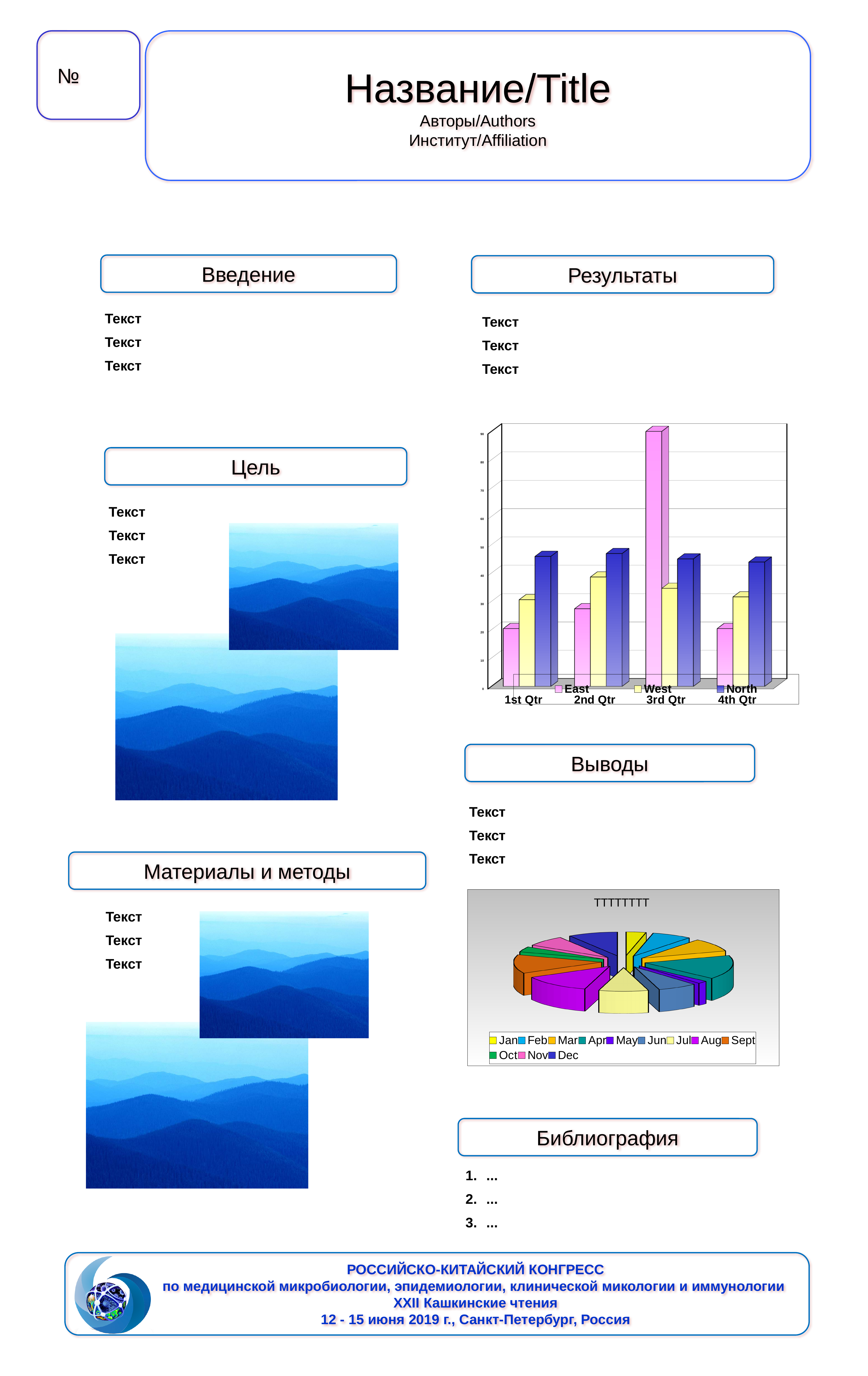
In the bar chart, which is larger for 1st Qtr: East or North? North What is the title of the pie chart? TTTTTTTT In the bar chart, is the North value for 1st Qtr greater or less than 40? greater In the bar chart, is the East value for 1st Qtr greater or less than 30? less In the bar chart, is the East value for 3rd Qtr greater or less than 80? greater How many entries does the legend of the pie chart list? 12 How many quarters are shown on the x axis of the bar chart? 4 In the bar chart, which quarter has the highest East value? 3rd Qtr In the bar chart, which is larger for 2nd Qtr: East or West? West What kind of chart is shown in the Результаты section? bar chart What kind of chart is shown below the Выводы section? pie chart How many series does the legend of the bar chart list? 3